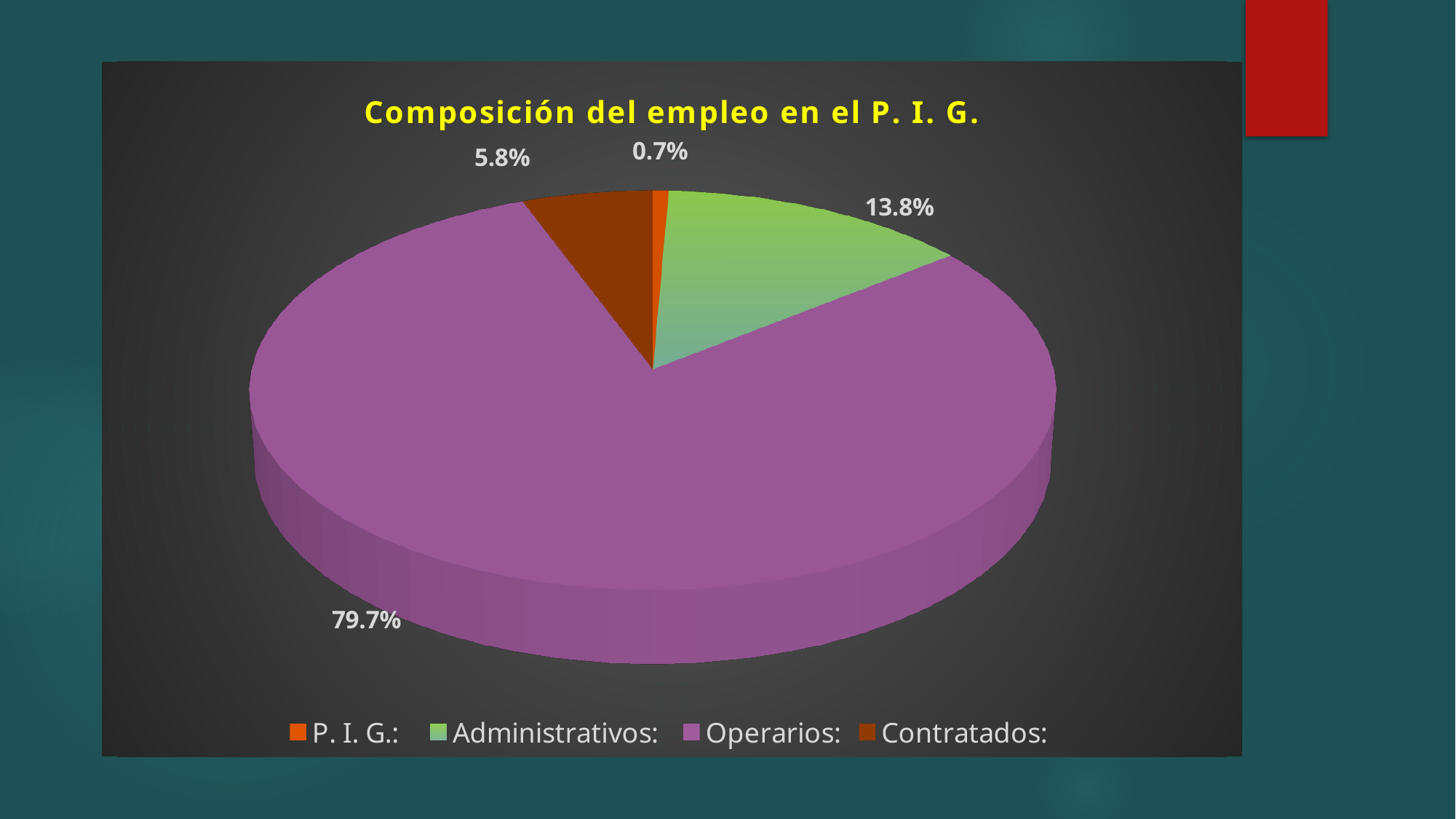
What percentage of the pie does Operarios represent? 79.7% How many categories does the pie chart show? 4 Which category has the largest share of the pie? Operarios What is the title of the chart? Composición del empleo en el P. I. G. What percentage of the pie does Administrativos represent? 13.8% What is the difference in percentage points between Administrativos and Contratados? 8.0 What percentage of the pie does Contratados represent? 5.8% What kind of chart is shown on the slide? Pie chart Which category has the smallest share of the pie? P. I. G. What percentage of the pie does P. I. G. represent? 0.7% Which is larger, the share for Contratados or the share for Administrativos? Administrativos What colour is the Operarios slice? Purple